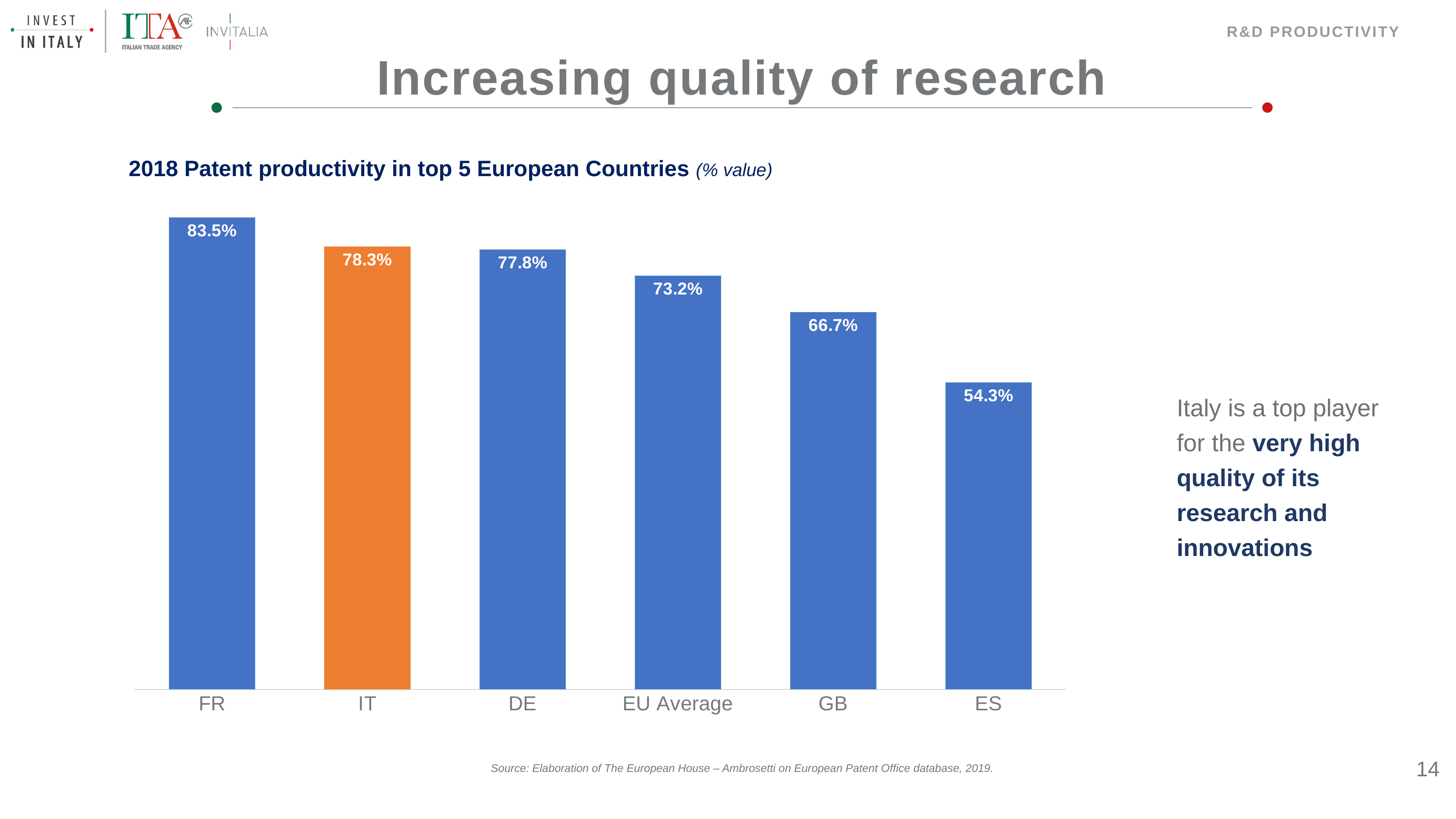
Which category has the highest value? FR What is the patent productivity value for FR? 83.5% What is the difference between the values for GB and ES? 12.4% Which bar is coloured orange instead of blue? IT How many bars are shown in the chart? 6 What is the value shown for ES? 54.3% What type of chart is shown on the slide? Bar chart Which is larger, the value for IT or the value for DE? IT Which category has the lowest value? ES What is the difference between the values for FR and IT? 5.2% What is the patent productivity value for IT? 78.3% What is the value shown for EU Average? 73.2%